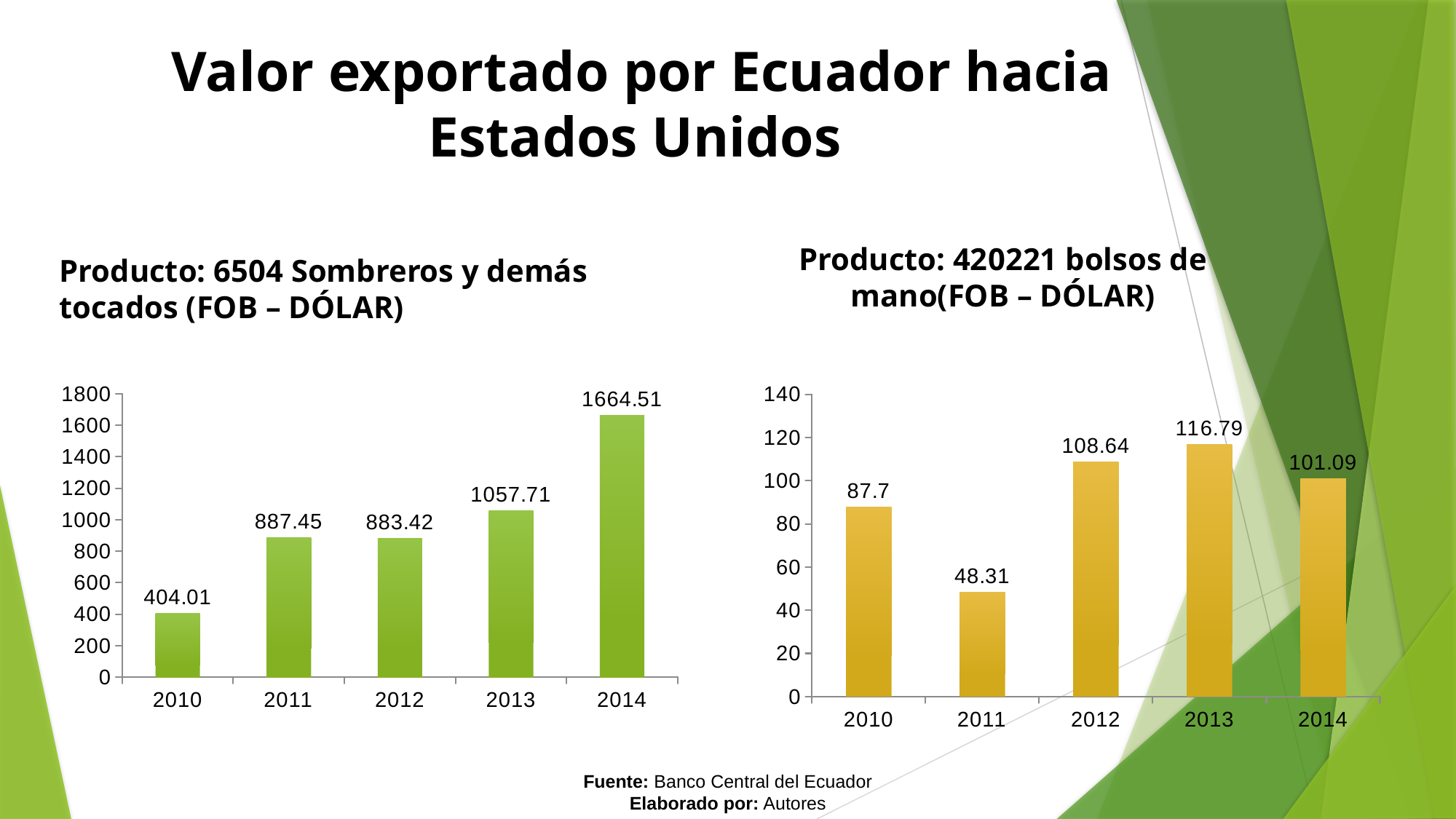
How many years are shown in the chart for 420221 bolsos de mano? 5 In the chart for 6504 Sombreros y demás tocados, what is the difference between the 2014 and 2013 values? 606.8 What type of chart is used for 6504 Sombreros y demás tocados? Bar chart In the chart for 420221 bolsos de mano, which year has the larger value, 2012 or 2014? 2012 In the chart for 6504 Sombreros y demás tocados, is the value for 2013 greater or less than 1000? greater In the chart for 6504 Sombreros y demás tocados, what was the value exported in 2014? 1664.51 In the chart for 420221 bolsos de mano, what was the value exported in 2011? 48.31 In the chart for 420221 bolsos de mano, which year has the lowest value? 2011 In the chart for 420221 bolsos de mano, what was the value exported in 2013? 116.79 In the chart for 6504 Sombreros y demás tocados, which year has the highest value? 2014 In the chart for 420221 bolsos de mano, what is the difference between the 2013 and 2011 values? 68.48 In the chart for 6504 Sombreros y demás tocados, what was the value exported in 2010? 404.01